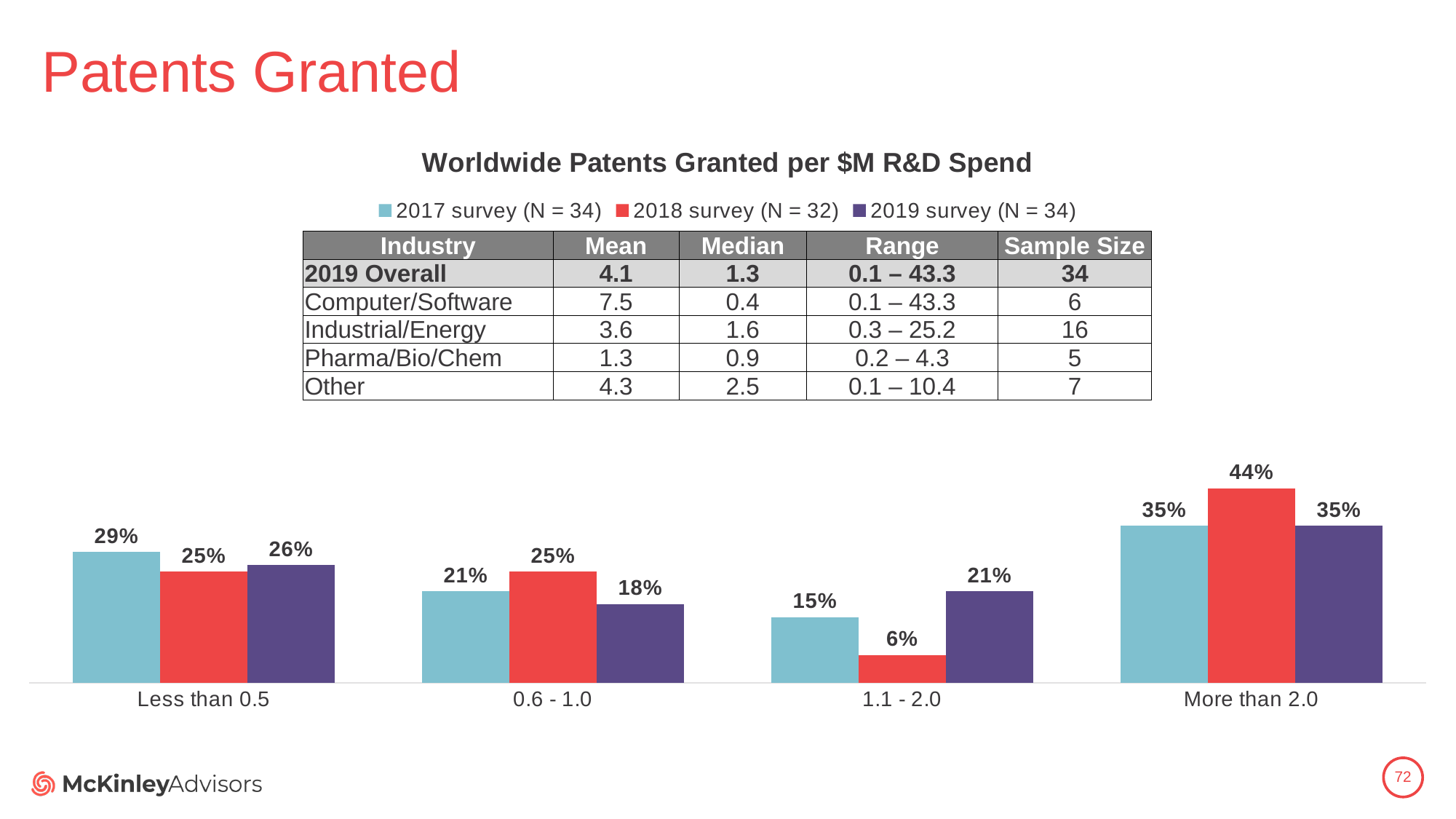
How many series does the legend list? 3 How many categories are shown on the x axis? 4 What is the value for the 2018 survey in the 'More than 2.0' category? 44% What is the value for the 2019 survey in the '1.1 - 2.0' category? 21% What is the title of the chart? Worldwide Patents Granted per $M R&D Spend What is the difference between the 2017 survey and 2018 survey values in the '1.1 - 2.0' category? 9% What kind of chart is shown on the slide? Bar chart What is the value for the 2017 survey in the 'Less than 0.5' category? 29% Which category has the lowest value for the 2018 survey? 1.1 - 2.0 Which category has the highest value for the 2019 survey? More than 2.0 What is the sample size for the 2018 survey according to the legend? 32 In the '0.6 - 1.0' category, which is larger: the 2018 survey value or the 2019 survey value? 2018 survey